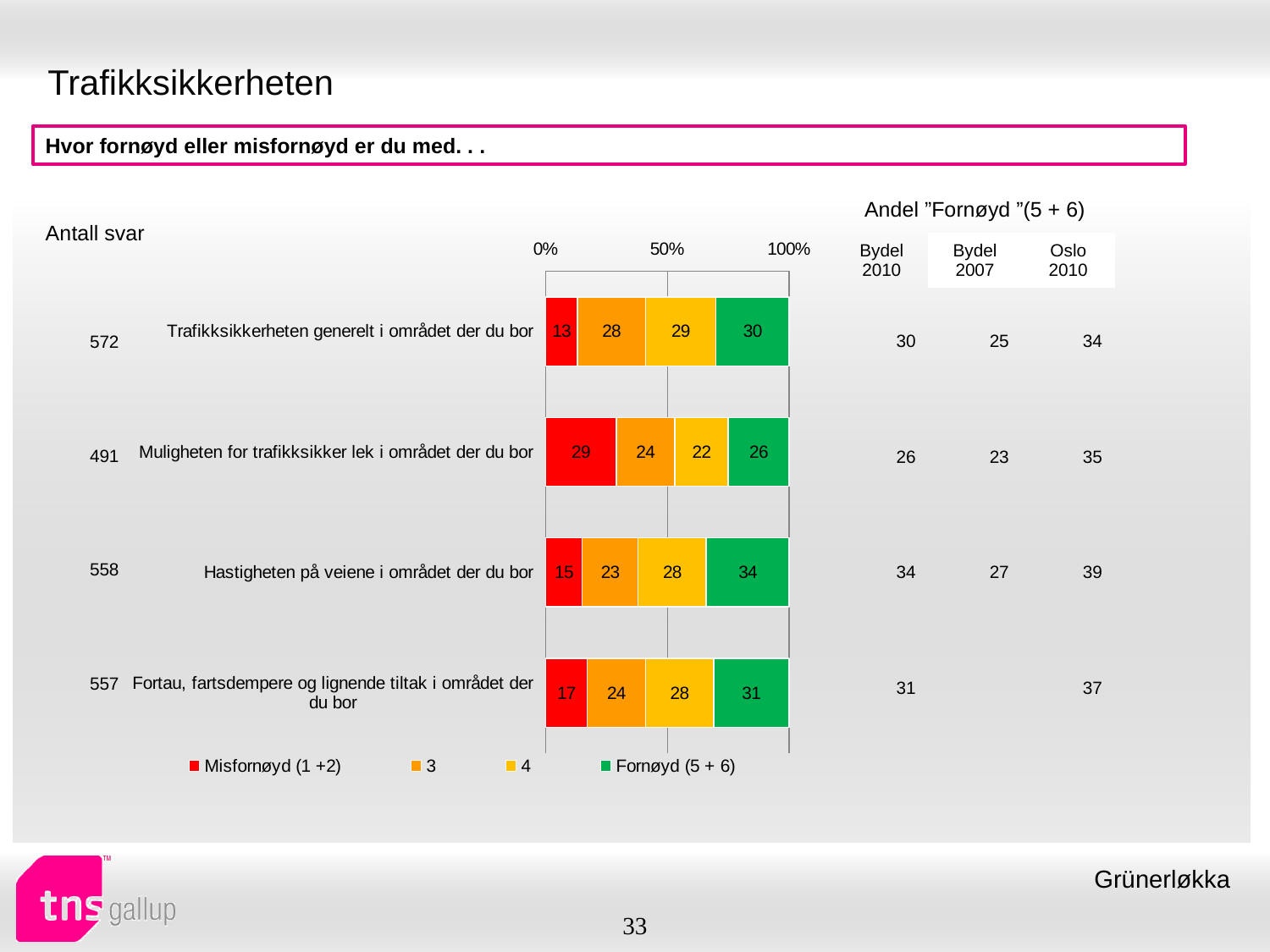
Which category has the highest 'Fornøyd (5 + 6)' value? Hastigheten på veiene i området der du bor What is the value of series '4' for 'Trafikksikkerheten generelt i området der du bor'? 29 What kind of chart is shown on the slide? Stacked bar chart What is the difference between the 'Misfornøyd (1 +2)' values for 'Muligheten for trafikksikker lek i området der du bor' and 'Trafikksikkerheten generelt i området der du bor'? 16 Which colour represents 'Fornøyd (5 + 6)' in the chart? Green What is the value of 'Misfornøyd (1 +2)' for 'Muligheten for trafikksikker lek i området der du bor'? 29 Which category has the lowest 'Misfornøyd (1 +2)' value? Trafikksikkerheten generelt i området der du bor How many series does the legend list? 4 How many categories are plotted in the chart? 4 What is the total of the stacked bar for 'Trafikksikkerheten generelt i området der du bor'? 100 What is the value of 'Fornøyd (5 + 6)' for 'Hastigheten på veiene i området der du bor'? 34 Which is larger: the 'Fornøyd (5 + 6)' value for 'Fortau, fartsdempere og lignende tiltak i området der du bor' or for 'Muligheten for trafikksikker lek i området der du bor'? Fortau, fartsdempere og lignende tiltak i området der du bor